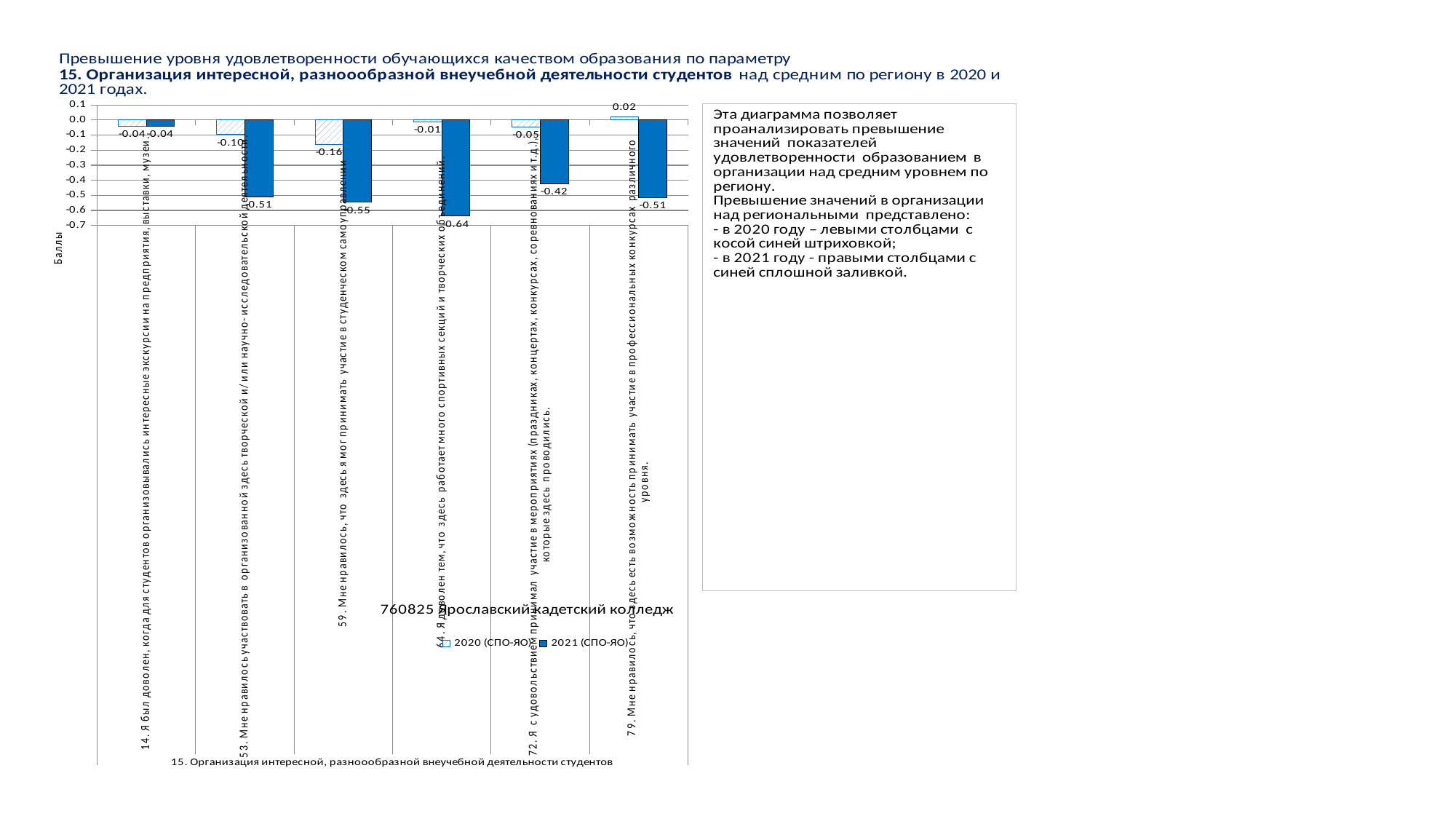
Is the 2021 (СПО-ЯО) value for question 72 greater or less than -0.3? less Which category has the highest 2020 (СПО-ЯО) value? 79. Мне нравилось, что здесь есть возможность принимать участие в профессиональных конкурсах различного уровня How many series does the chart legend list? 2 What is the 2021 (СПО-ЯО) value for question 64 (Я доволен тем, что здесь работает много спортивных секций и творческих объединений)? -0.64 What type of chart is shown on the slide? bar chart What is the 2020 (СПО-ЯО) value for question 79 (Мне нравилось, что здесь есть возможность принимать участие в профессиональных конкурсах различного уровня)? 0.02 Which is larger for question 72: the 2020 (СПО-ЯО) value or the 2021 (СПО-ЯО) value? 2020 (СПО-ЯО) How many categories (questions) are plotted on the x axis of the chart? 6 What is the 2020 (СПО-ЯО) value for question 59 (Мне нравилось, что здесь я мог принимать участие в студенческом самоуправлении)? -0.16 Which category has the lowest 2021 (СПО-ЯО) value? 64. Я доволен тем, что здесь работает много спортивных секций и творческих объединений What is the difference between the 2020 and 2021 (СПО-ЯО) values for question 53 (Мне нравилось участвовать в организованной здесь творческой и/или научно-исследовательской деятельности)? 0.41